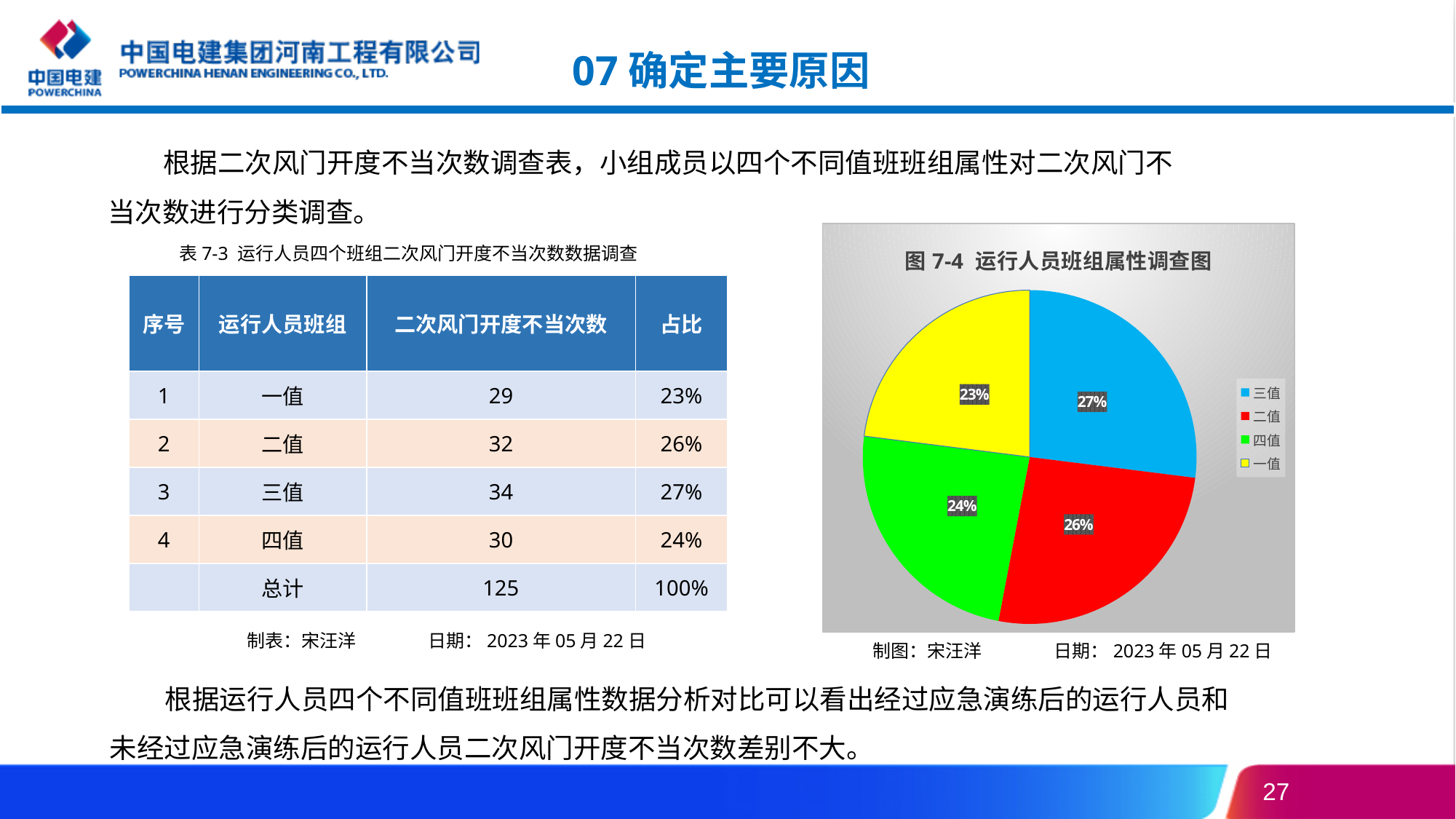
How many entries does the legend of the pie chart 图 7-4 list? 4 In the pie chart 图 7-4, what percentage is shown for 二值? 26% In the pie chart 图 7-4, what colour is the slice for 四值? green In the pie chart 图 7-4, what is the difference in percentage points between 三值 and 一值? 4 In the pie chart 图 7-4, which group has the smallest share? 一值 In the pie chart 图 7-4, what percentage is shown for 一值? 23% In the pie chart 图 7-4, which group has the largest share? 三值 In the pie chart 图 7-4, what percentage is shown for 三值? 27% How many slices does the pie chart 图 7-4 have? 4 What kind of chart is shown in 图 7-4 运行人员班组属性调查图? pie chart In the pie chart 图 7-4, which has a larger share, 二值 or 四值? 二值 In the pie chart 图 7-4, what percentage is shown for 四值? 24%